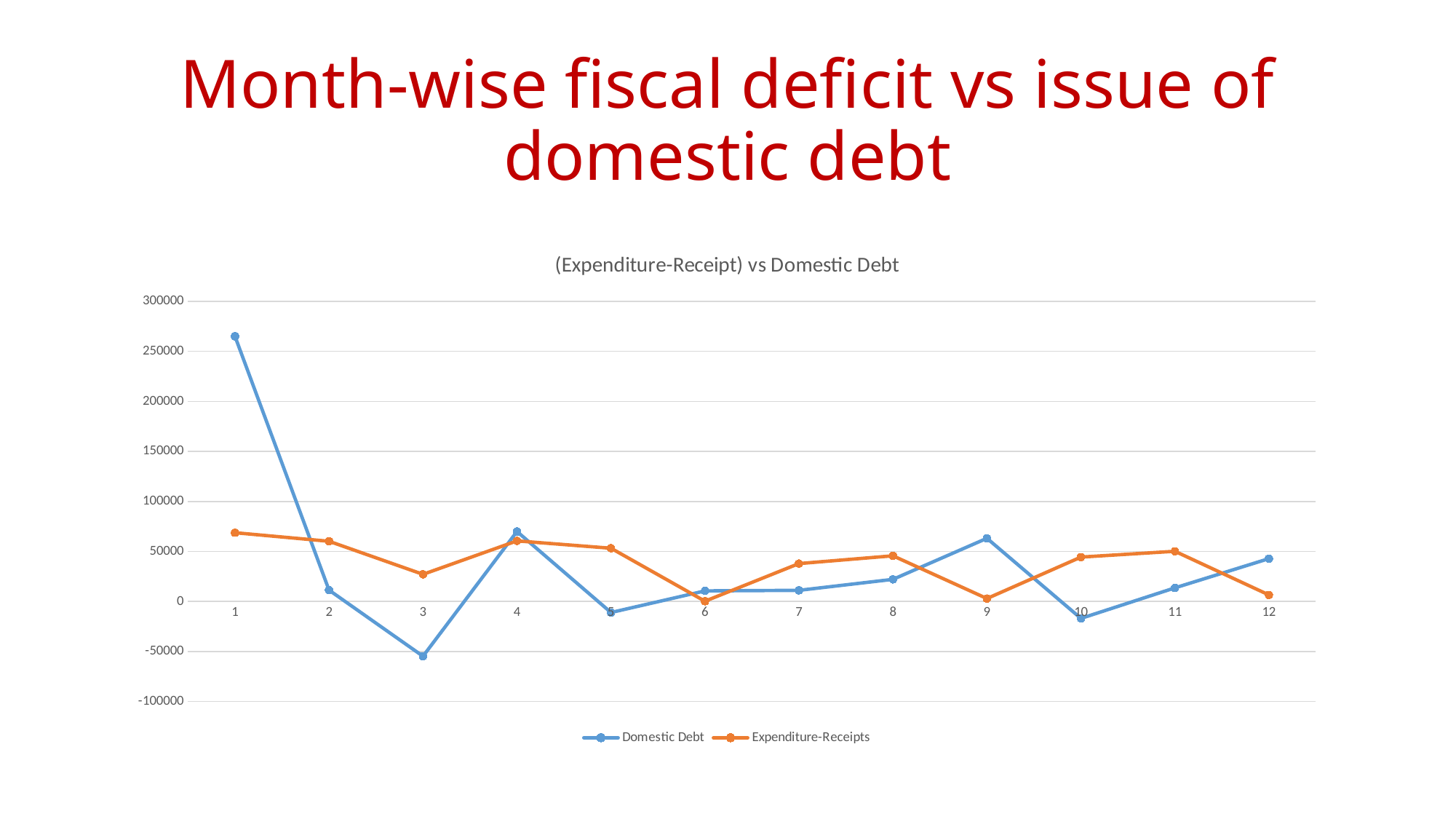
What is the title printed above the chart? (Expenditure-Receipt) vs Domestic Debt In month 3, which series has the larger value, Domestic Debt or Expenditure-Receipts? Expenditure-Receipts Is the Domestic Debt value for month 3 greater or less than 0? less In which month is the Expenditure-Receipts value highest? 1 How many series does the legend list? 2 In month 9, which series has the larger value, Domestic Debt or Expenditure-Receipts? Domestic Debt What kind of chart is shown on the slide? line chart In which month is the Domestic Debt value highest? 1 Is the Expenditure-Receipts value for month 1 greater or less than 50000? greater How many months (points) are plotted along the x axis? 12 In which month is the Domestic Debt value lowest? 3 Is the Domestic Debt value for month 1 greater or less than 250000? greater